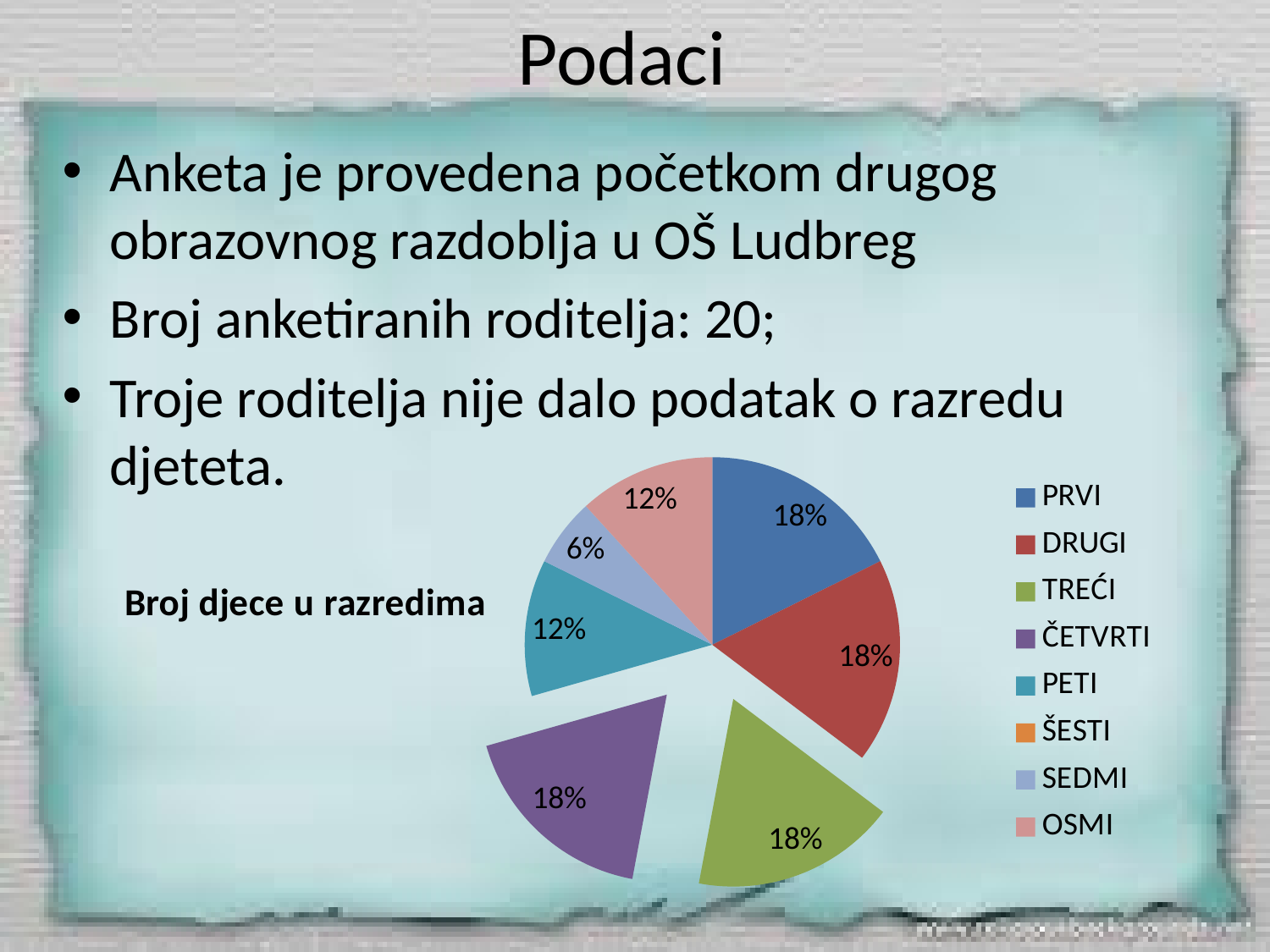
How many categories does the legend list? 8 What share of the pie does OSMI have? 12% What share of the pie does ČETVRTI have? 18% What share of the pie does DRUGI have? 18% What share of the pie does TREĆI have? 18% What share of the pie does SEDMI have? 6% What is the title of the chart? Broj djece u razredima What kind of chart is shown on the slide? pie chart What share of the pie does PRVI have? 18% Which is larger, the share for PETI or the share for SEDMI? PETI What share of the pie does PETI have? 12% What is the difference between the share for PRVI and the share for SEDMI? 12%